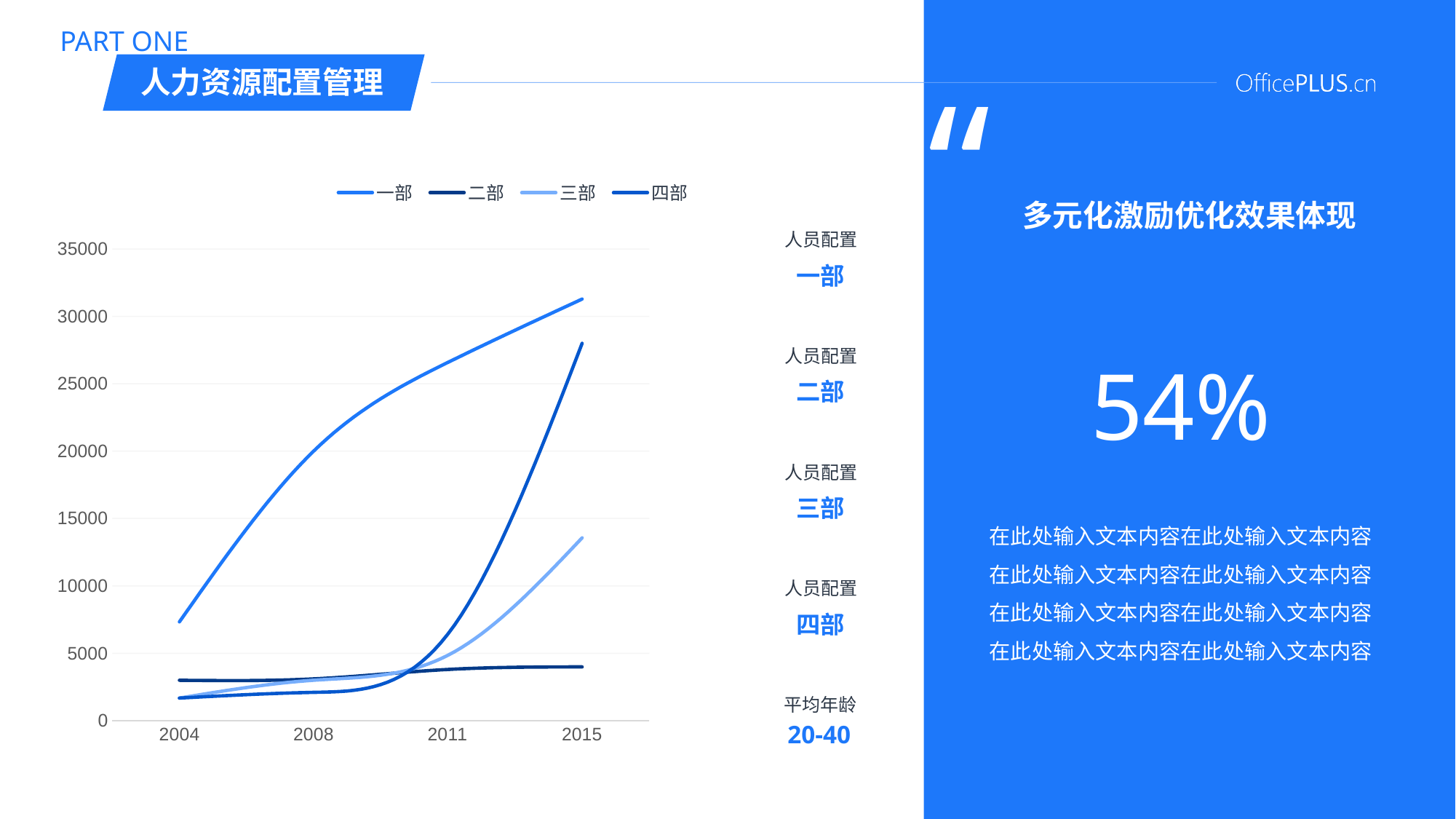
Which series has the highest value in 2004? 一部 Is the value for 三部 in 2015 greater or less than 15000? less Which series has the highest value in 2015? 一部 In 2015, which series has the larger value, 四部 or 三部? 四部 Is the value for 一部 in 2004 greater or less than 5000? greater Is the value for 一部 in 2015 greater or less than 30000? greater What kind of chart is shown on the slide? line chart How many series does the chart legend list? 4 Does the 一部 series rise or fall from 2004 to 2015? rise Which series has the lowest value in 2015? 二部 How many years are labelled on the x axis of the chart? 4